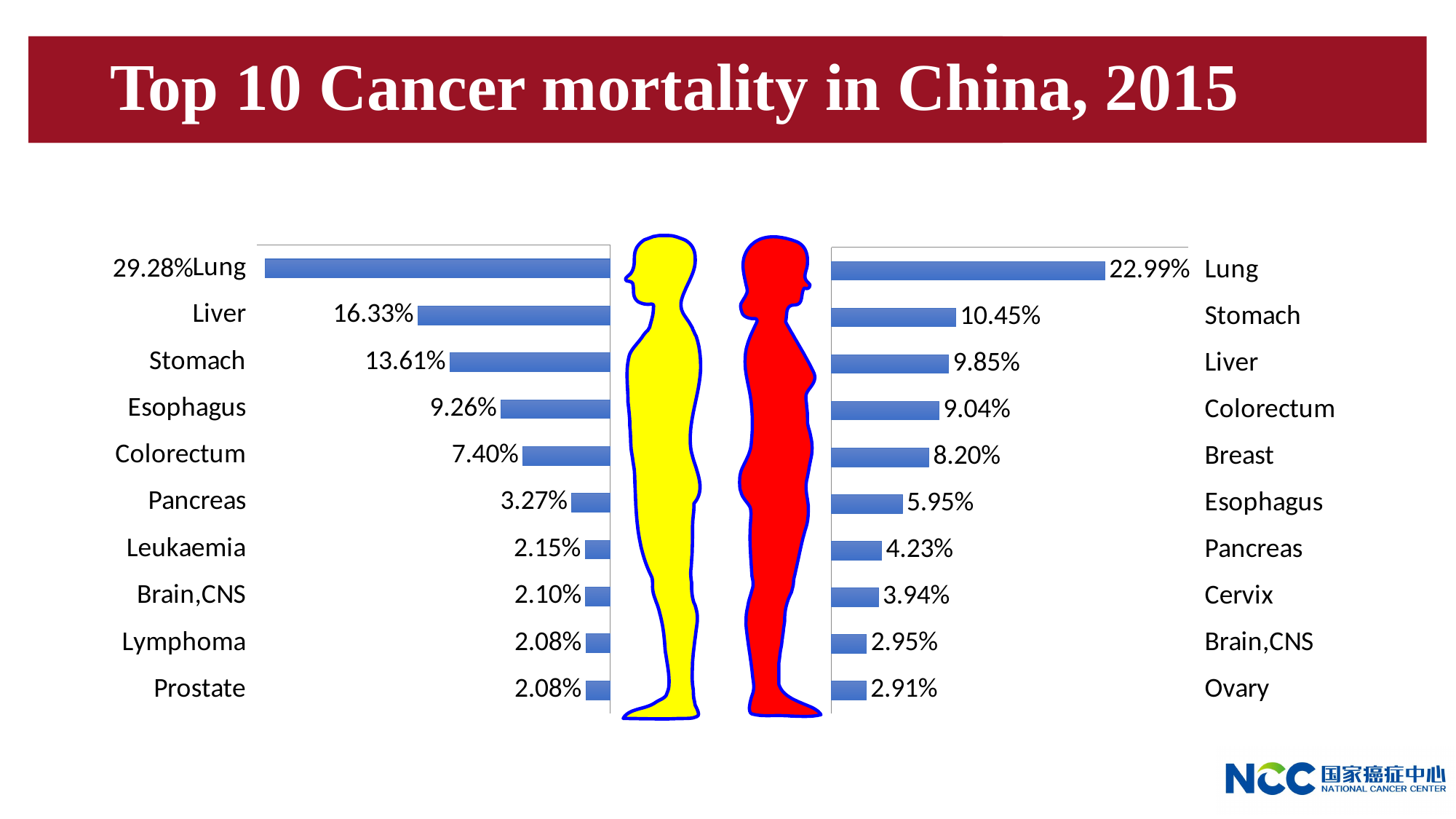
In the right chart, what is the value for Stomach? 10.45% In the right chart, which category has the highest value? Lung In the right chart, what is the value for Breast? 8.20% What is the title of the slide? Top 10 Cancer mortality in China, 2015 In the right chart, which category has the lowest value? Ovary In the left chart, what is the value for Lung? 29.28% What kind of chart is the right chart? Bar chart In the right chart, what is the difference between the values for Colorectum and Esophagus? 3.09% In the left chart, what is the difference between the values for Lung and Liver? 12.95% Which is larger: the value for Stomach in the left chart or the value for Stomach in the right chart? Left chart (13.61%) How many categories are shown in the left chart? 10 In the left chart, what is the value for Esophagus? 9.26%